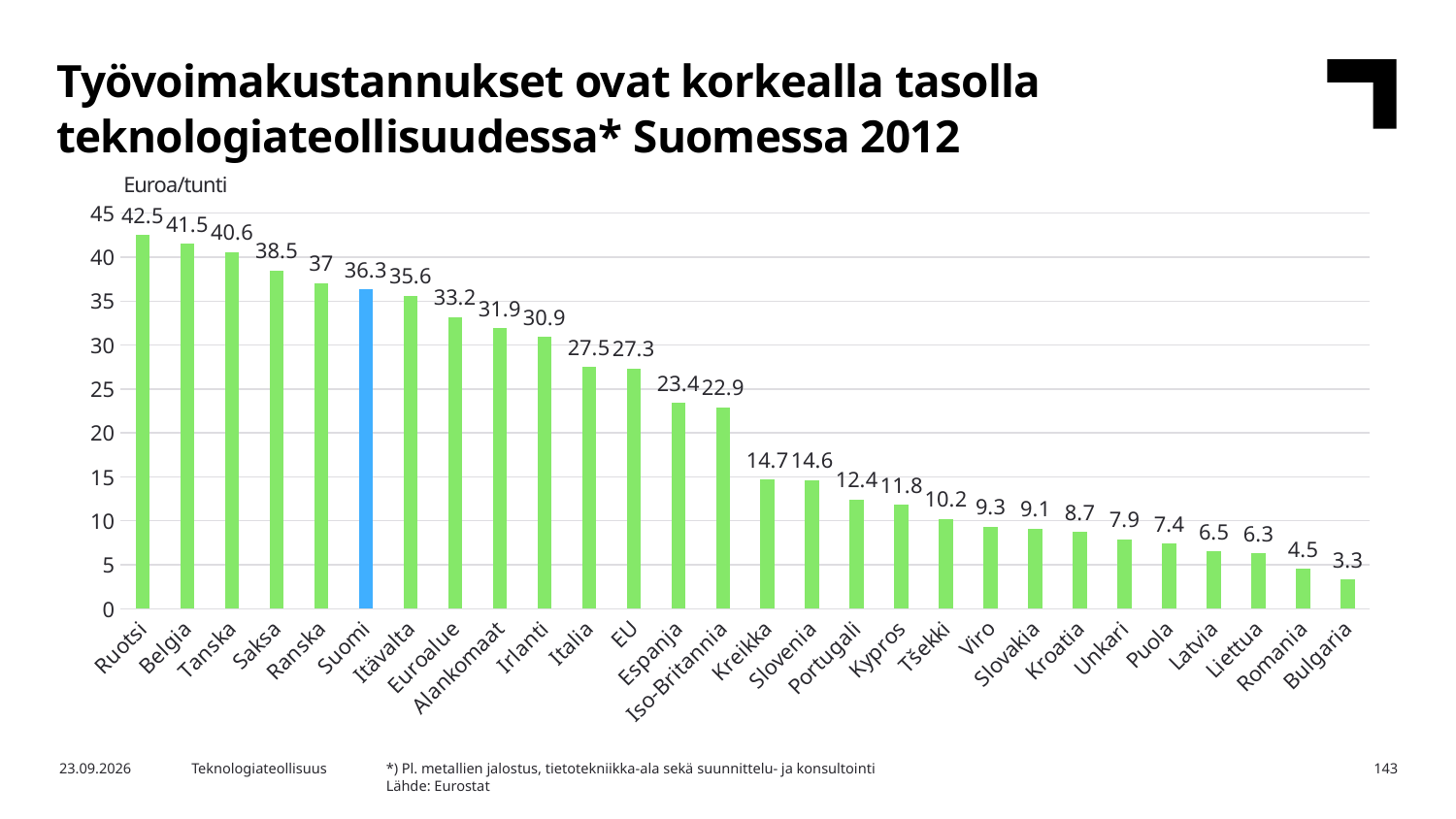
Which country has the highest value? Ruotsi What kind of chart is this? bar chart Which bar is coloured blue instead of green? Suomi Do the values rise or fall from left to right along the x axis? fall Which is larger, the value for Saksa or the value for Itävalta? Saksa What is the value for Suomi? 36.3 What is the value for Alankomaat? 31.9 What is the difference between the values for Ruotsi and Suomi? 6.2 Which country has the lowest value? Bulgaria What is the difference between the values for EU and Euroalue? 5.9 What is the value for Kypros? 11.8 How many countries or regions are shown on the x axis? 28